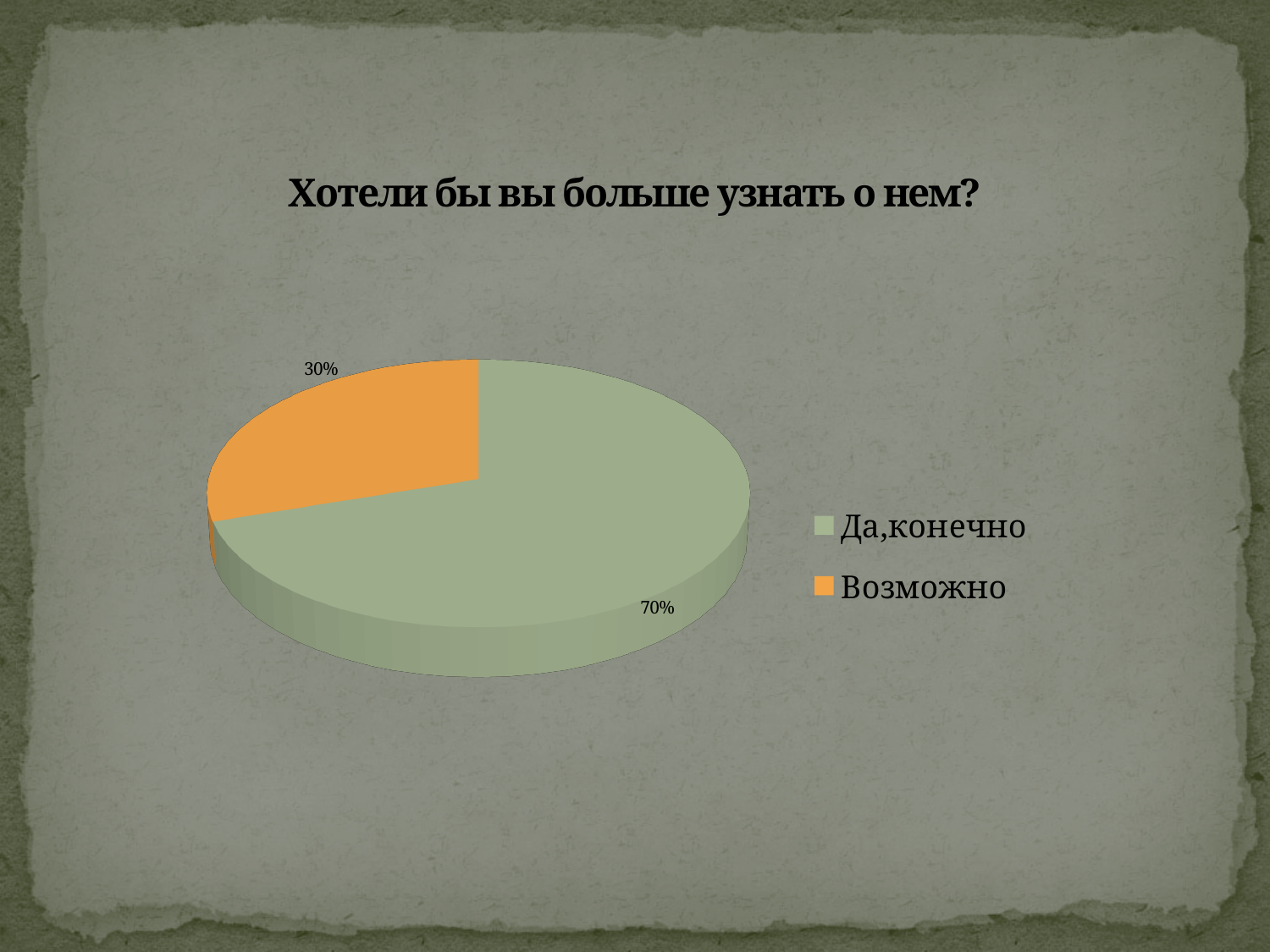
What percentage of the pie does the "Возможно" slice represent? 30% Which slice is larger, "Да,конечно" or "Возможно"? Да,конечно Which category has the smallest share of the pie? Возможно What percentage of the pie does the "Да,конечно" slice represent? 70% What colour is the "Возможно" slice? Orange What kind of chart is shown on the slide? Pie chart How many entries does the legend list? 2 Which category has the largest share of the pie? Да,конечно What is the difference in percentage points between the "Да,конечно" and "Возможно" slices? 40 What is the title of the chart? Хотели бы вы больше узнать о нем? How many slices does the pie chart have? 2